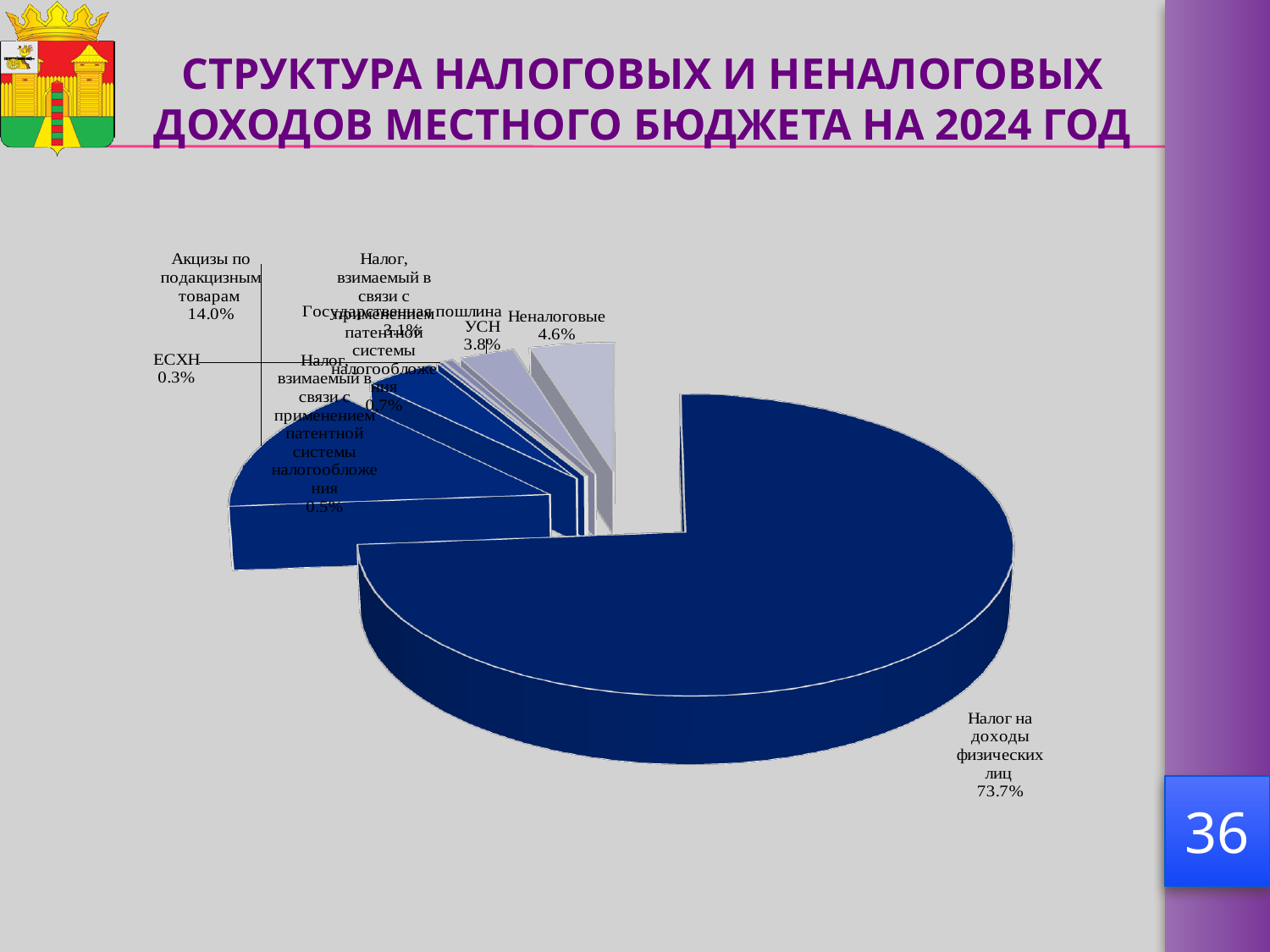
What share is shown for "Акцизы по подакцизным товарам"? 14.0% What share is shown for "ЕСХН"? 0.3% Which is larger, the share for "УСН" or for "Неналоговые"? Неналоговые What kind of chart is shown on the slide? pie chart What share is shown for "Неналоговые"? 4.6% What share is shown for "УСН"? 3.8% By how many percentage points does "Налог на доходы физических лиц" exceed "Акцизы по подакцизным товарам"? 59.7 What share of the pie is labelled for "Налог на доходы физических лиц"? 73.7% What is the difference between the shares of "Неналоговые" and "УСН"? 0.8 Which category has the largest slice of the pie? Налог на доходы физических лиц What year does the slide title say the budget revenue structure refers to? 2024 Which labelled category has the smallest share? ЕСХН